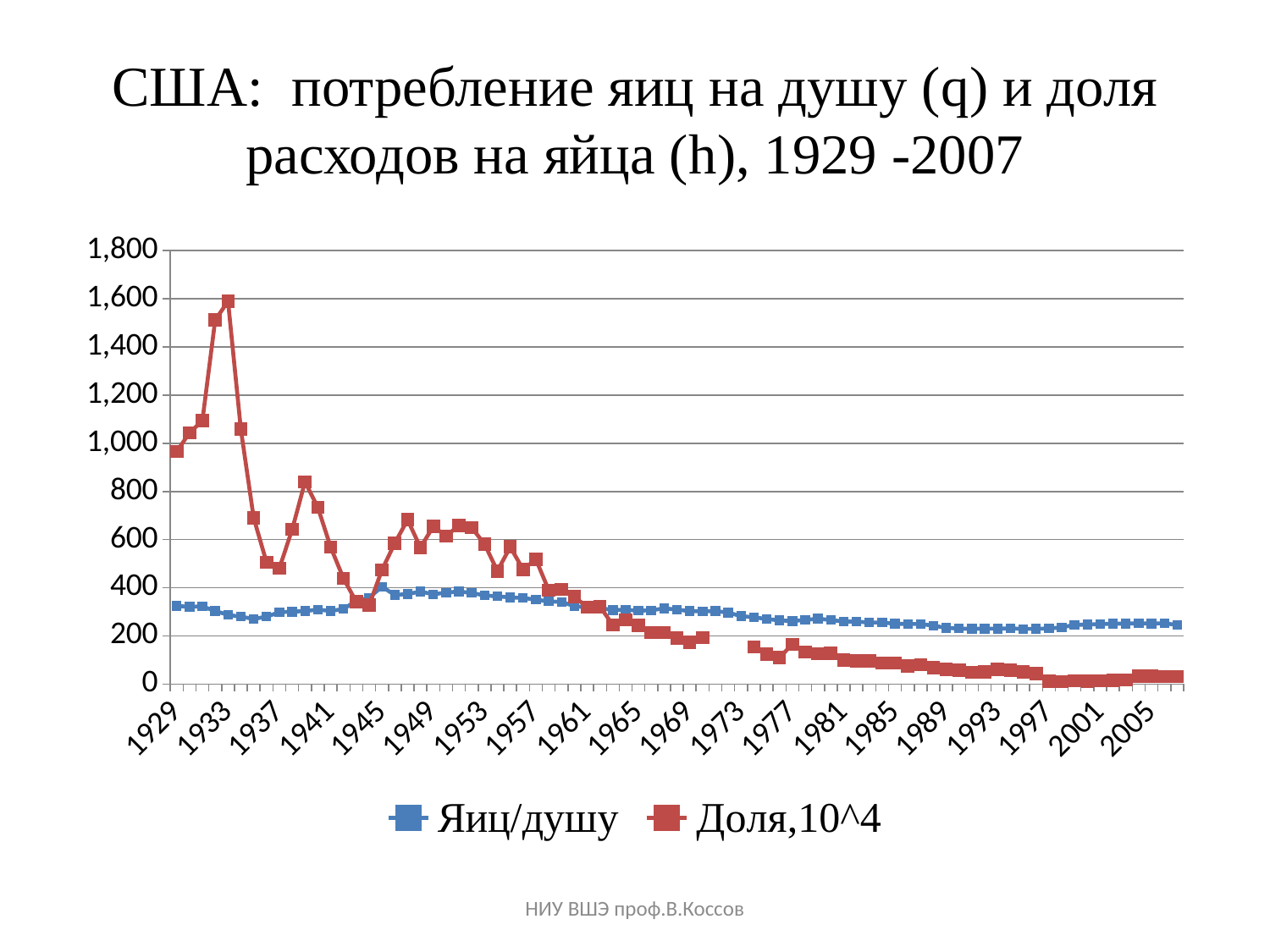
In 1929, which series has the higher value, Яиц/душу or Доля,10^4? Доля,10^4 Is the value of Доля,10^4 in 2005 greater or less than 200? less How many series does the legend list? 2 What are the two series named in the legend? Яиц/душу and Доля,10^4 In 1985, which series has the higher value, Яиц/душу or Доля,10^4? Яиц/душу Is the value of Доля,10^4 in 1929 greater or less than 800? greater Is the value of Яиц/душу in 1929 greater or less than 400? less Which series is drawn in red? Доля,10^4 What kind of chart is shown on the slide? line chart Does the Доля,10^4 series overall rise or fall from 1929 to 2007? fall